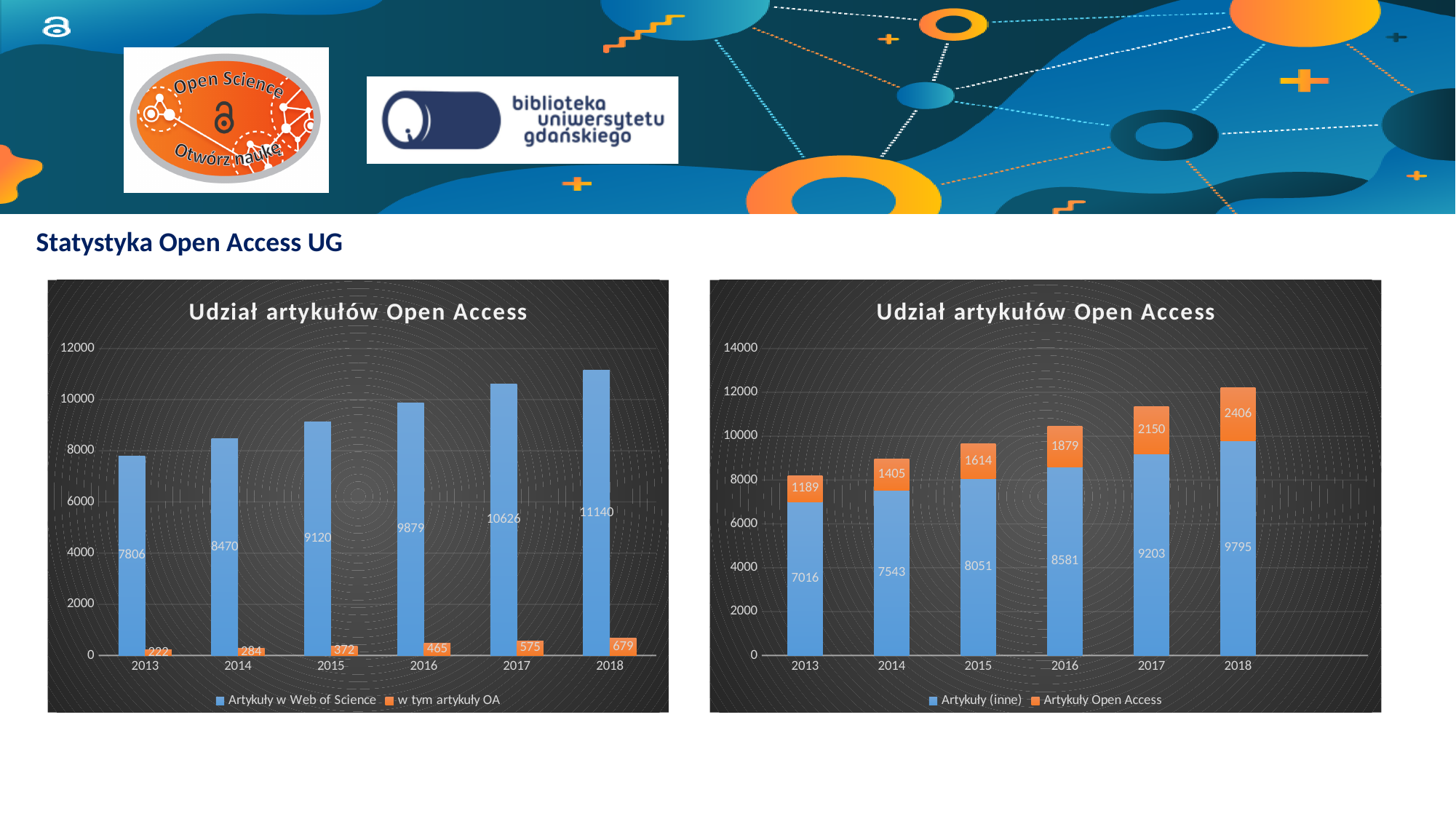
In the left chart, what is the value for w tym artykuły OA in 2018? 679 In the left chart, do the values for w tym artykuły OA rise or fall from 2014 to 2018? rise In the right chart, what is the value for Artykuły (inne) in 2014? 7543 In the right chart, what is the value for Artykuły Open Access in 2017? 2150 How many series does the legend of the right chart list? 2 In the right chart, is the value for Artykuły Open Access larger in 2015 or in 2016? 2016 In the left chart, what is the value for Artykuły w Web of Science in 2016? 9879 In the right chart, what is the total of the stacked bar for 2018? 12201 In the left chart, what is the difference between the Artykuły w Web of Science values for 2018 and 2013? 3334 In the right chart, which year has the lowest value for Artykuły Open Access? 2013 What kind of chart is the left chart? bar chart In the left chart, which year has the highest value for Artykuły w Web of Science? 2018